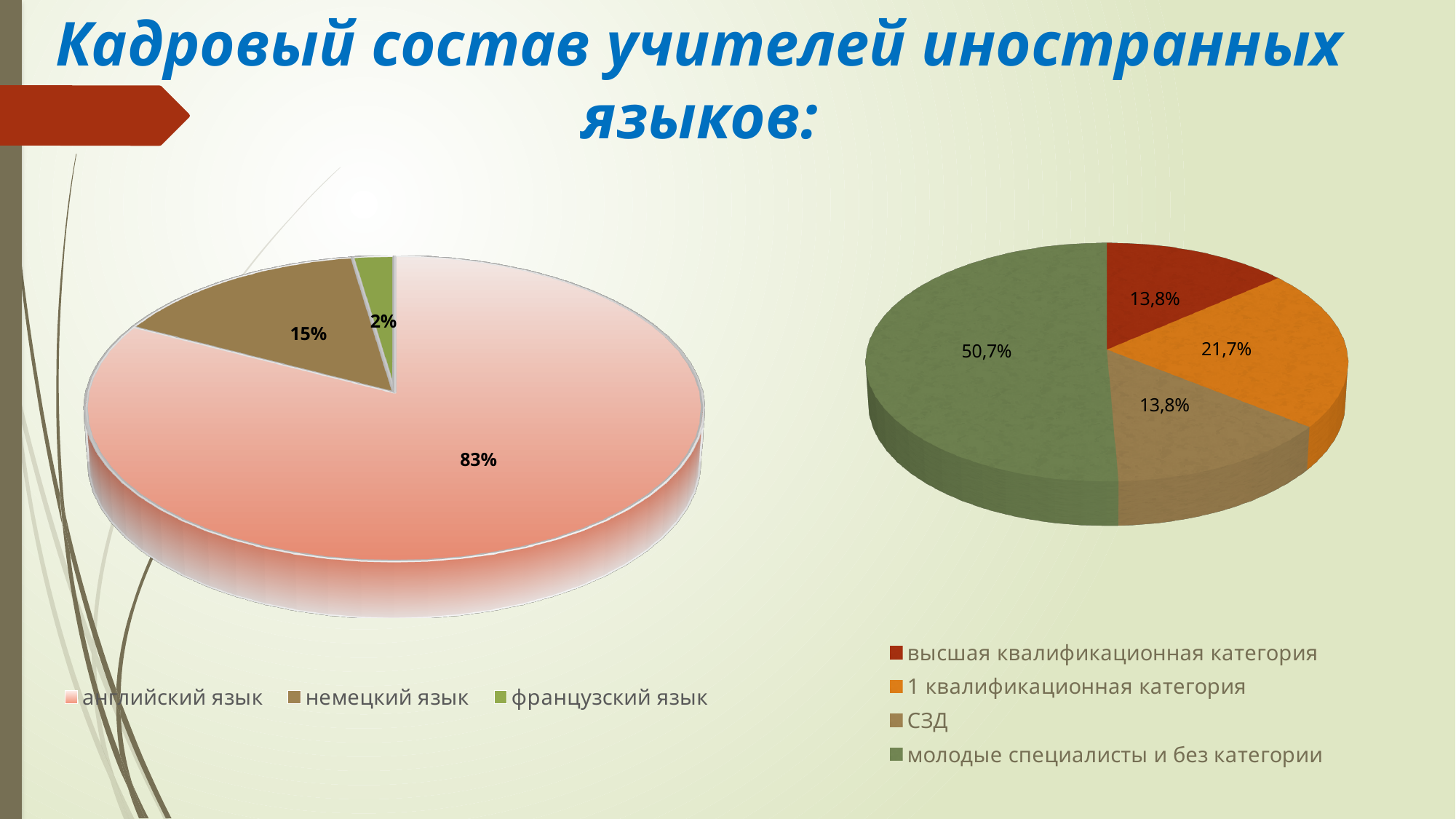
In the left pie chart, what share is shown for немецкий язык? 15% How many slices does the left pie chart have? 3 How many categories does the legend of the right pie chart list? 4 In the left pie chart, what share is shown for английский язык? 83% In the right pie chart, what share is shown for 1 квалификационная категория? 21,7% In the right pie chart, what share is shown for молодые специалисты и без категории? 50,7% In the left pie chart, which language has the smallest slice? французский язык In the right pie chart, which is larger: the share for 1 квалификационная категория or the share for СЗД? 1 квалификационная категория In the left pie chart, what is the difference between the shares for английский язык and немецкий язык? 68% In the right pie chart, what colour is the slice for высшая квалификационная категория? red What kind of chart is the chart on the left of the slide? pie chart In the right pie chart, which category has the largest slice? молодые специалисты и без категории